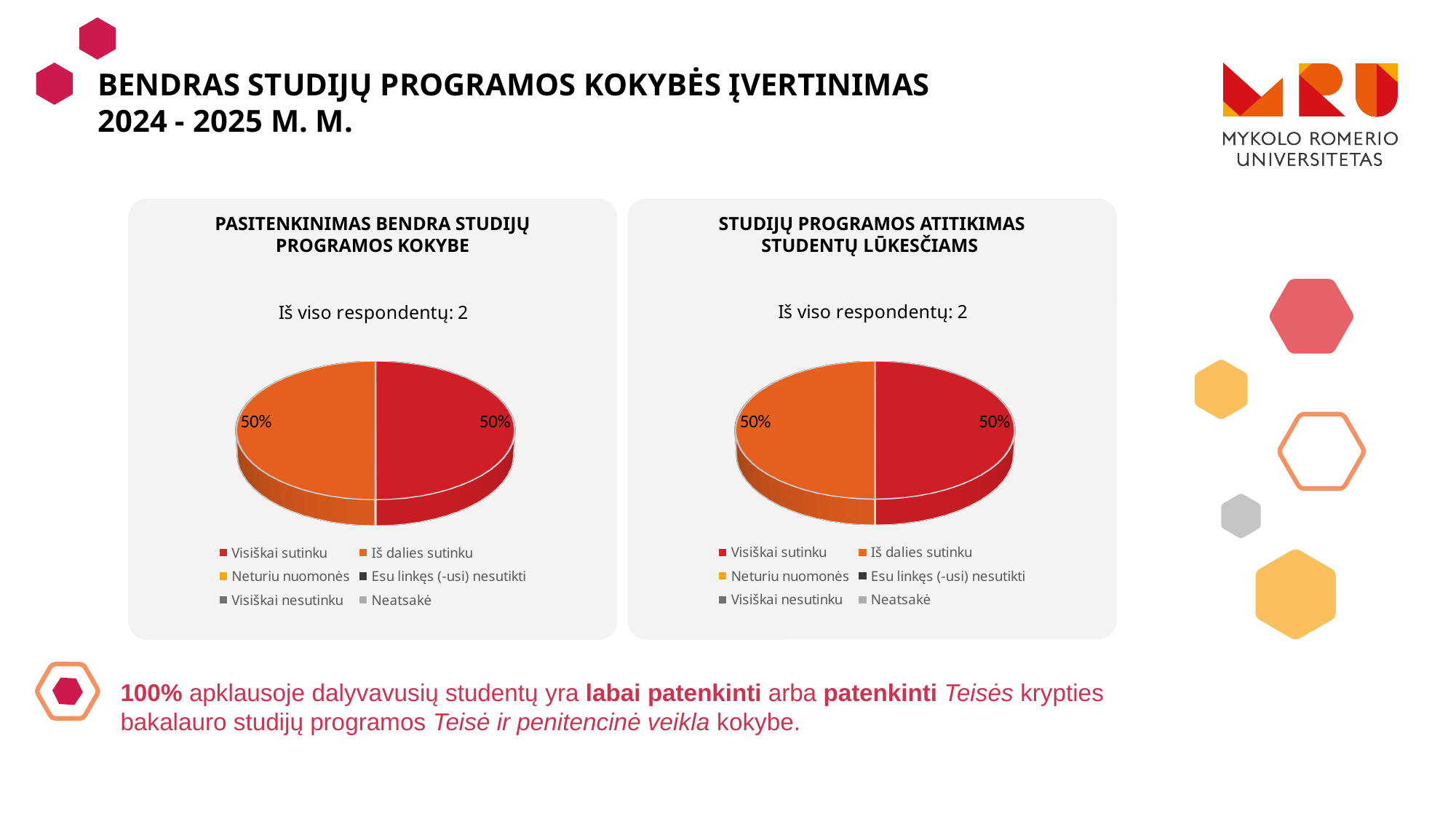
How many slices with a data label are visible in the right chart (STUDIJŲ PROGRAMOS ATITIKIMAS STUDENTŲ LŪKESČIAMS)? 2 In the right chart (STUDIJŲ PROGRAMOS ATITIKIMAS STUDENTŲ LŪKESČIAMS), what value is shown for "Visiškai sutinku"? 50% What kind of chart is shown in the left panel titled "PASITENKINIMAS BENDRA STUDIJŲ PROGRAMOS KOKYBE"? pie chart How many entries does the legend of the right chart (STUDIJŲ PROGRAMOS ATITIKIMAS STUDENTŲ LŪKESČIAMS) list? 6 How many slices with a data label are visible in the left chart (PASITENKINIMAS BENDRA STUDIJŲ PROGRAMOS KOKYBE)? 2 In the left chart (PASITENKINIMAS BENDRA STUDIJŲ PROGRAMOS KOKYBE), what value is shown for "Iš dalies sutinku"? 50% In the left chart (PASITENKINIMAS BENDRA STUDIJŲ PROGRAMOS KOKYBE), what share of the pie is "Visiškai sutinku"? 50% How many respondents in total does the right chart (STUDIJŲ PROGRAMOS ATITIKIMAS STUDENTŲ LŪKESČIAMS) report ("Iš viso respondentų")? 2 What kind of chart is shown in the right panel titled "STUDIJŲ PROGRAMOS ATITIKIMAS STUDENTŲ LŪKESČIAMS"? pie chart In the right chart (STUDIJŲ PROGRAMOS ATITIKIMAS STUDENTŲ LŪKESČIAMS), what share of the pie is "Iš dalies sutinku"? 50% How many entries does the legend of the left chart (PASITENKINIMAS BENDRA STUDIJŲ PROGRAMOS KOKYBE) list? 6 In the left chart (PASITENKINIMAS BENDRA STUDIJŲ PROGRAMOS KOKYBE), what is the difference between the "Visiškai sutinku" and "Iš dalies sutinku" shares? 0%